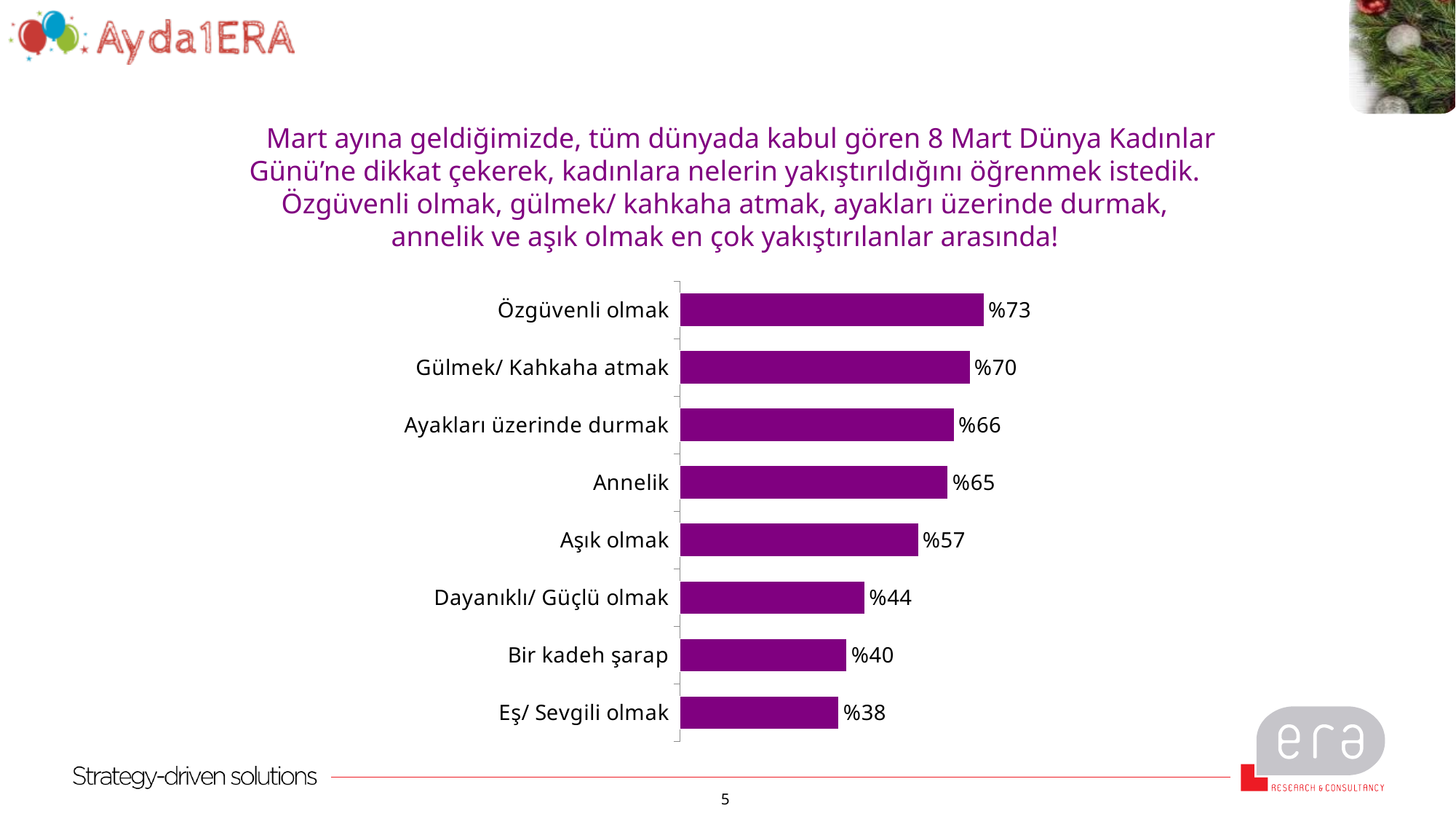
What is the difference between the values for Özgüvenli olmak and Eş/ Sevgili olmak? %35 Which category has the lowest value? Eş/ Sevgili olmak How many categories are shown in the chart? 8 What is the value for Bir kadeh şarap? %40 What is the value for Özgüvenli olmak? %73 Which category has the highest value? Özgüvenli olmak Do the values rise or fall going from the top bar to the bottom bar? Fall What kind of chart is shown on the slide? Bar chart What is the value for Annelik? %65 Which is larger, the value for Gülmek/ Kahkaha atmak or the value for Aşık olmak? Gülmek/ Kahkaha atmak What is the difference between the values for Aşık olmak and Dayanıklı/ Güçlü olmak? %13 What colour are the bars in the chart? Purple